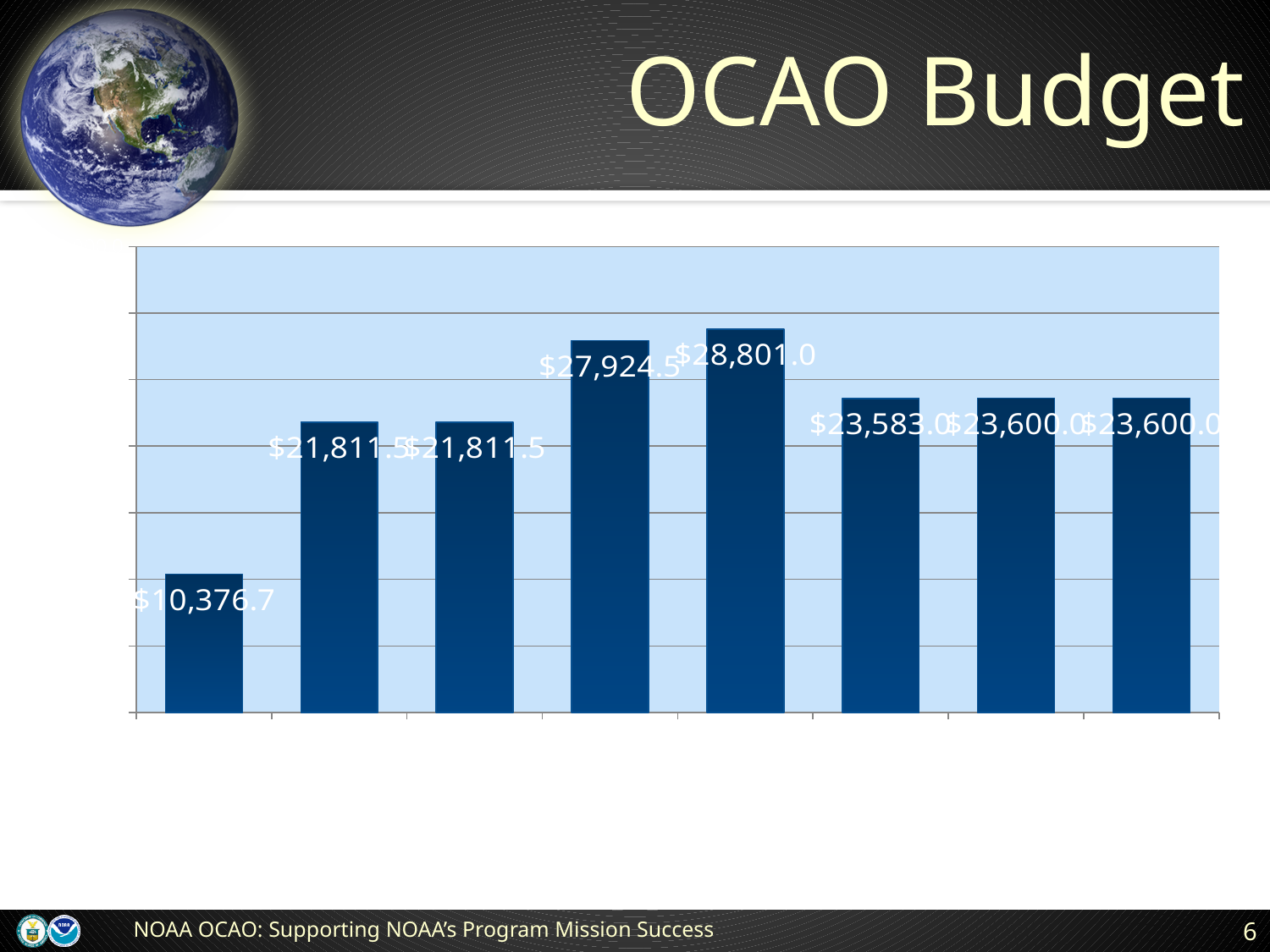
What is the lowest value labelled in the chart? $10,376.7 Which is larger, the value of the second bar or the value of the first bar? the second bar ($21,811.5) How many bars are plotted in the chart? 8 What kind of chart is shown on the slide? bar chart What is the value shown on the sixth bar from the left? $23,583.0 What is the value shown on the fifth bar from the left? $28,801.0 What is the difference between the fifth bar ($28,801.0) and the fourth bar ($27,924.5)? $876.5 What is the highest value labelled in the chart? $28,801.0 What is the title of the slide containing the chart? OCAO Budget Do the values rise or fall from the first bar to the fifth bar? rise What is the value shown on the first (leftmost) bar? $10,376.7 What is the value shown on the fourth bar from the left? $27,924.5